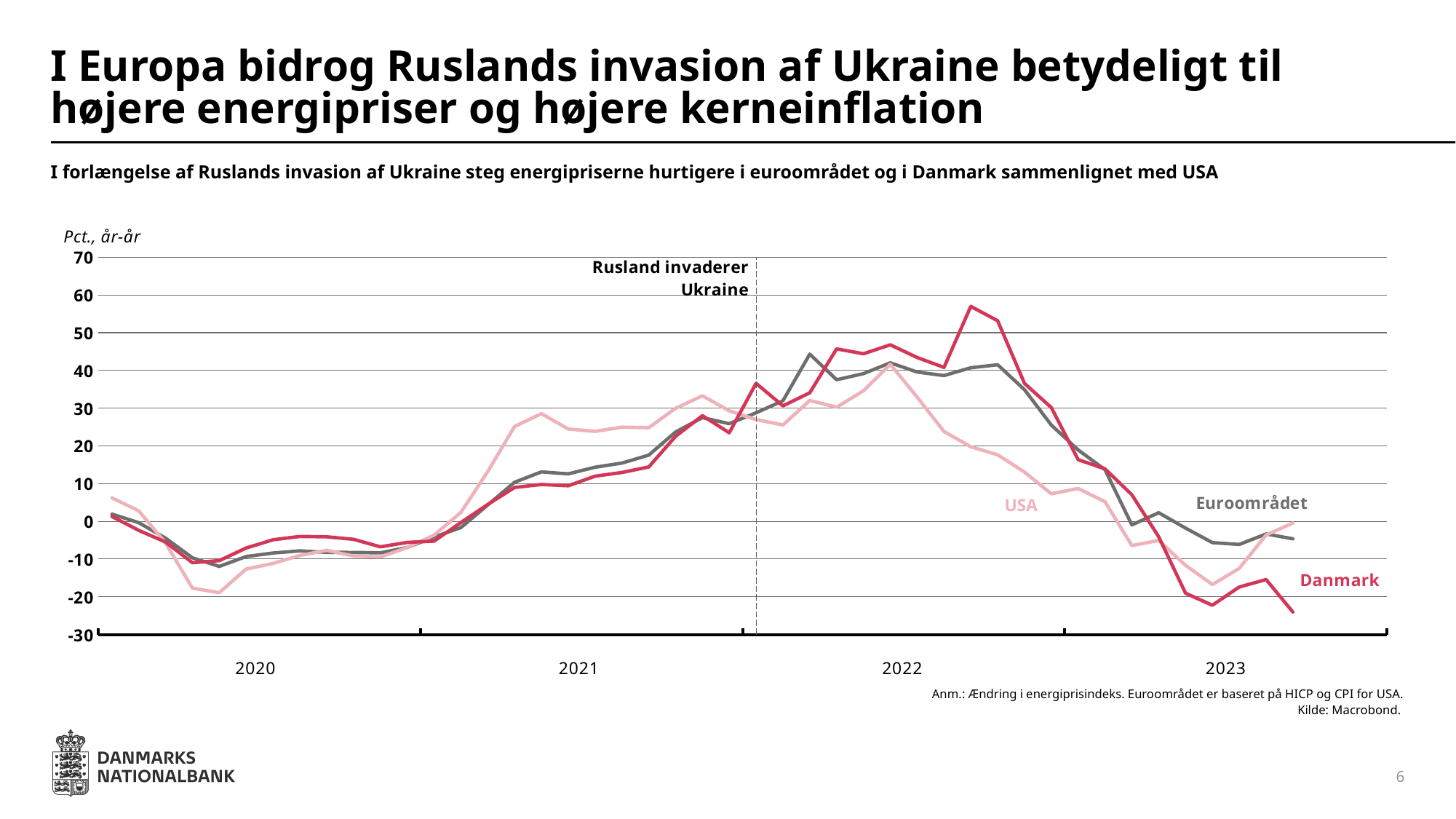
Which series dips lowest in 2020, USA or Danmark? USA Is the peak value for Danmark greater or less than 50? greater Which series has the lowest value at the end of the chart in 2023? Danmark What kind of chart is shown on the slide? line chart How many series are plotted in the chart? 3 Do the values for Danmark rise or fall from their 2022 peak to 2023? fall Is the final value for Danmark in 2023 greater or less than -20? less What is the unit label shown above the y axis? Pct., år-år Is the peak value for Euroområdet greater or less than 50? less Which series reaches the highest peak in the chart? Danmark What event does the dashed vertical line in the chart mark? Rusland invaderer Ukraine